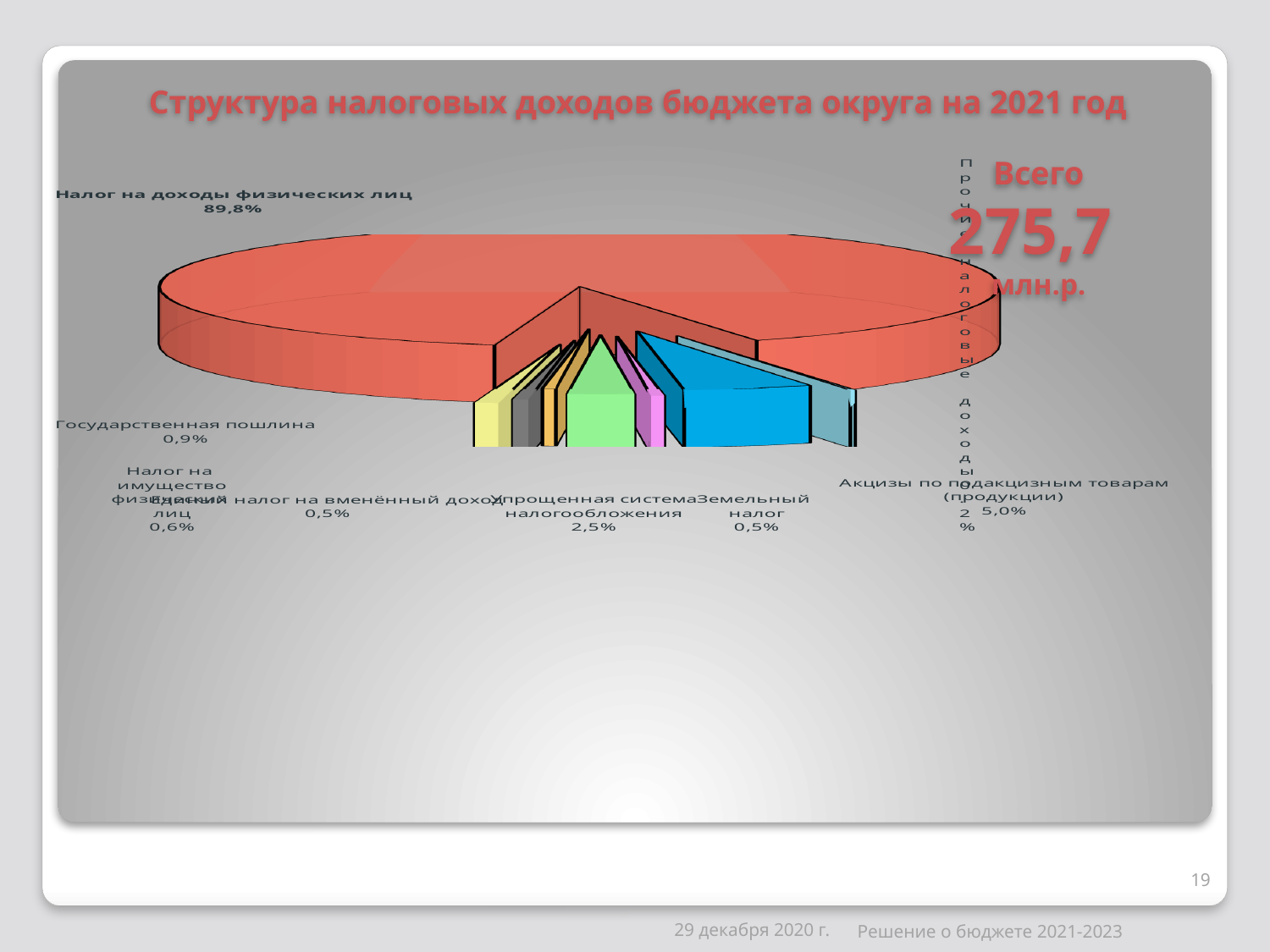
What share is shown for "Государственная пошлина"? 0,9% What share of tax revenues does "Налог на доходы физических лиц" account for? 89,8% What share is shown for "Налог на имущество физических лиц"? 0,6% What share is shown for "Акцизы по подакцизным товарам (продукции)"? 5,0% What kind of chart is shown on the slide? Pie chart What share is shown for "Упрощенная система налогообложения"? 2,5% What share is shown for "Земельный налог"? 0,5% How many categories (slices) are labelled in the chart? 8 By how many percentage points does the share of "Налог на доходы физических лиц" exceed that of "Акцизы по подакцизным товарам (продукции)"? 84,8% What total amount of tax revenues is stated next to the chart? 275,7 млн.р. Which category has the largest share of the pie? Налог на доходы физических лиц Which is larger: the share for "Акцизы по подакцизным товарам (продукции)" or for "Упрощенная система налогообложения"? Акцизы по подакцизным товарам (продукции)